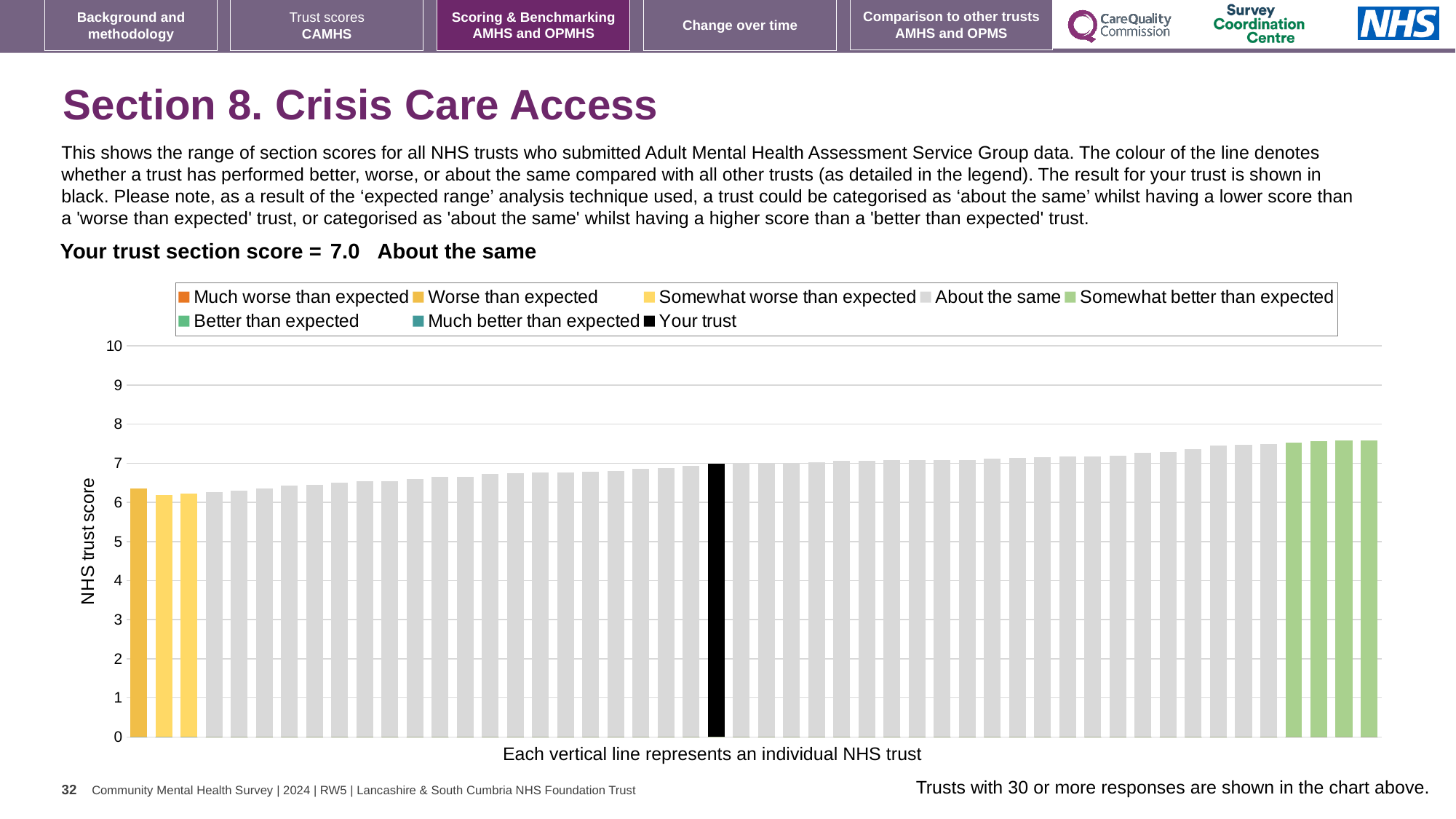
Is the value of the black bar (your trust) greater or less than 5? greater Is the value of the leftmost bar greater or less than 6? greater What is the section score for your trust shown on the slide? 7.0 How many entries does the chart legend list? 8 What is the label on the vertical axis of the chart? NHS trust score Which performance category is your trust placed in for Crisis Care Access? About the same What colour is used in the chart to show your trust? Black How many bars are coloured green (somewhat better than expected)? 4 Do the bar values rise or fall from left to right along the x axis? Rise Which is higher, the black bar for your trust or the leftmost bar? The black bar (your trust) Is the value of the rightmost bar greater or less than 8? less What kind of chart is shown on the slide? Bar chart